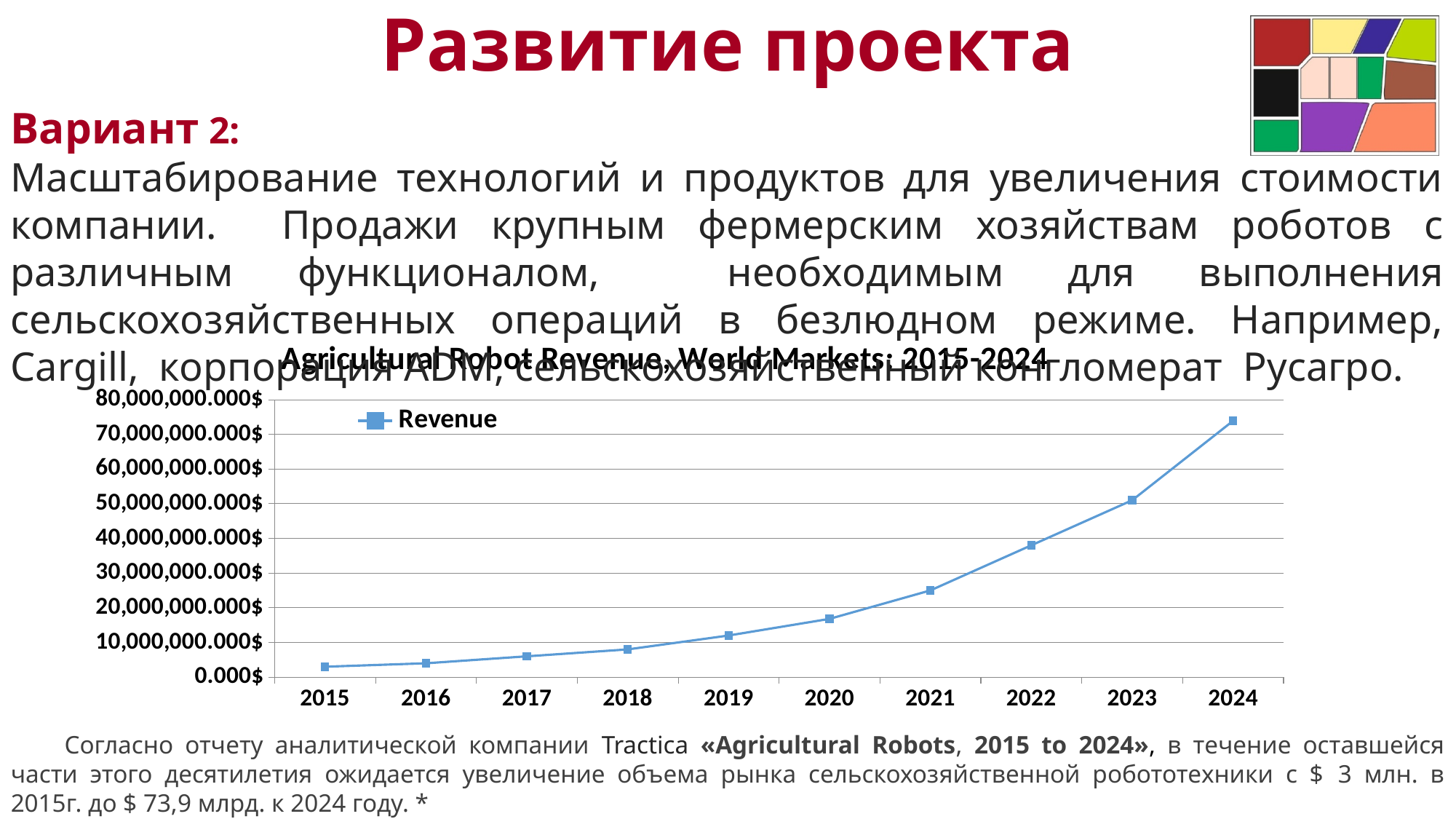
Do the revenue values rise or fall from 2015 to 2024? rise Is the revenue value for 2015 greater or less than 10,000,000.000$? less Which year has the larger revenue value, 2020 or 2023? 2023 Is the revenue value for 2024 greater or less than 70,000,000.000$? greater Which year has the lowest revenue value in the chart? 2015 How many years are plotted along the x axis of the chart? 10 How many series does the chart legend list? 1 Is the revenue value for 2021 greater or less than 20,000,000.000$? greater What kind of chart is shown on the slide? line chart What is the name of the series shown in the chart legend? Revenue Which year has the highest revenue value in the chart? 2024